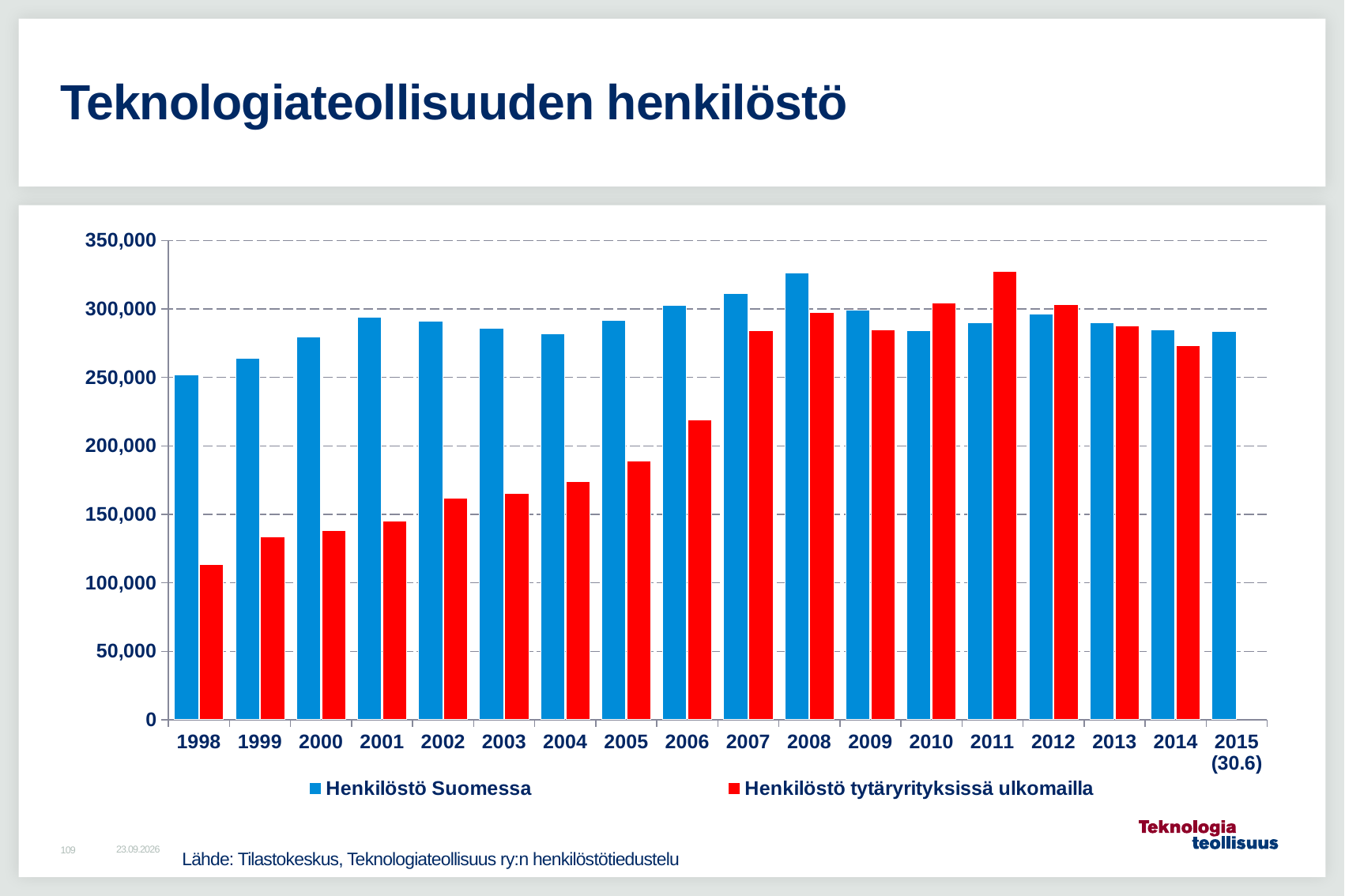
Is the value for Henkilöstö Suomessa in 2008 greater or less than 300,000? greater How many years (categories) are shown on the x axis? 18 In which year is the value for Henkilöstö tytäryrityksissä ulkomailla lowest? 1998 In which year is the value for Henkilöstö tytäryrityksissä ulkomailla highest? 2011 Is the value for Henkilöstö tytäryrityksissä ulkomailla in 1998 greater or less than 100,000? greater What kind of chart is shown on the slide? bar chart Is the value for Henkilöstö tytäryrityksissä ulkomailla in 2014 greater or less than 300,000? less In 2011, which series has the larger value: Henkilöstö Suomessa or Henkilöstö tytäryrityksissä ulkomailla? Henkilöstö tytäryrityksissä ulkomailla Does the value for Henkilöstö tytäryrityksissä ulkomailla generally rise or fall from 1998 to 2011? rise In 2006, which series has the larger value: Henkilöstö Suomessa or Henkilöstö tytäryrityksissä ulkomailla? Henkilöstö Suomessa How many series does the legend list? 2 In which year is the value for Henkilöstö Suomessa highest? 2008